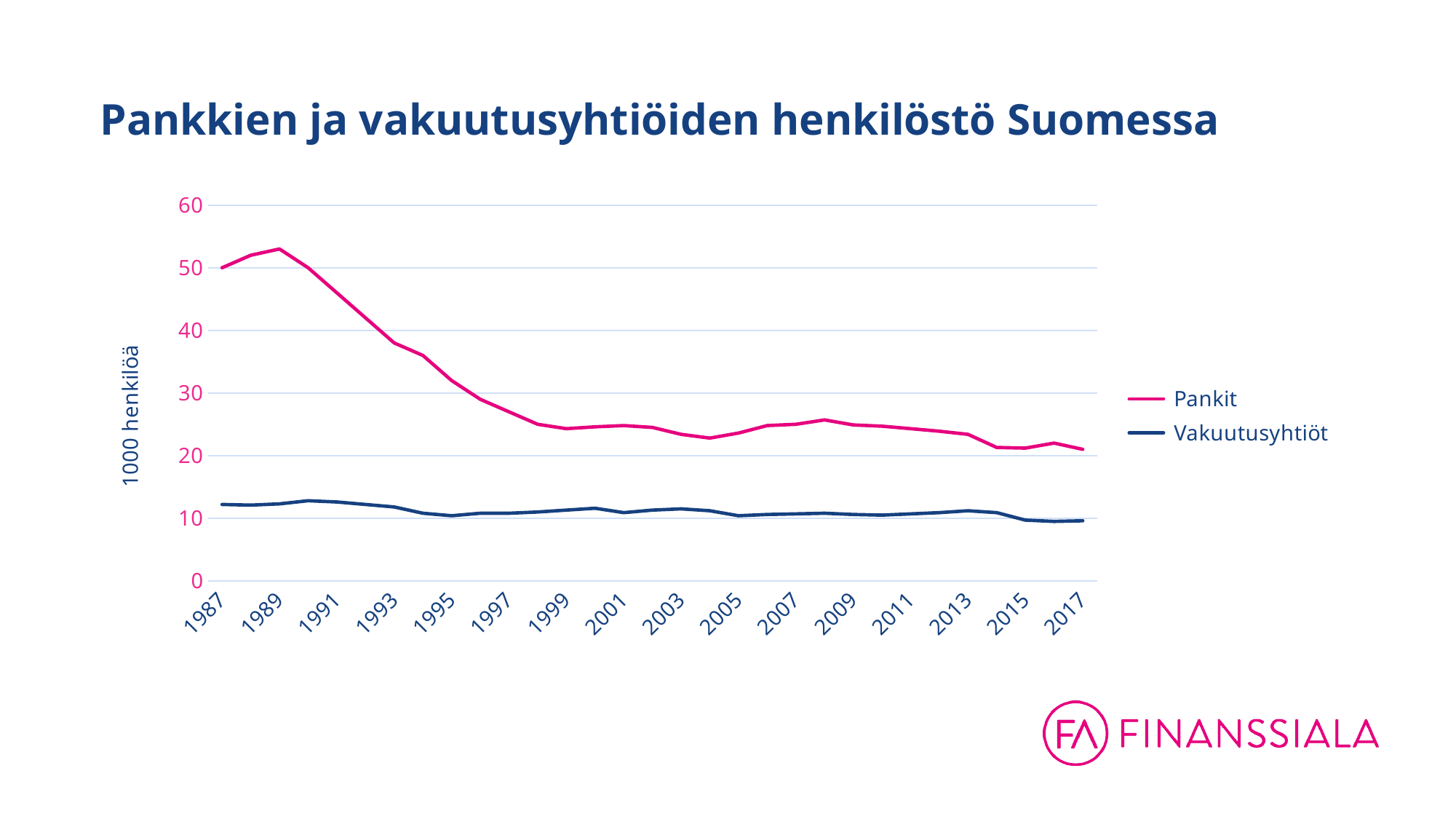
How many series does the legend list? 2 Is the value for Vakuutusyhtiöt in 2017 greater or less than 20? less Is the value for Pankit in 2017 greater or less than 30? less What is the label on the vertical axis? 1000 henkilöä In 1987, which series has the higher value, Pankit or Vakuutusyhtiöt? Pankit Is the value for Pankit in 1989 greater or less than 50? greater What are the two series named in the legend? Pankit and Vakuutusyhtiöt How many year labels are shown on the x axis? 16 In which year does the Pankit series reach its highest value? 1989 What type of chart is shown on the slide? line chart Does the Pankit line rise or fall overall from 1987 to 2017? fall